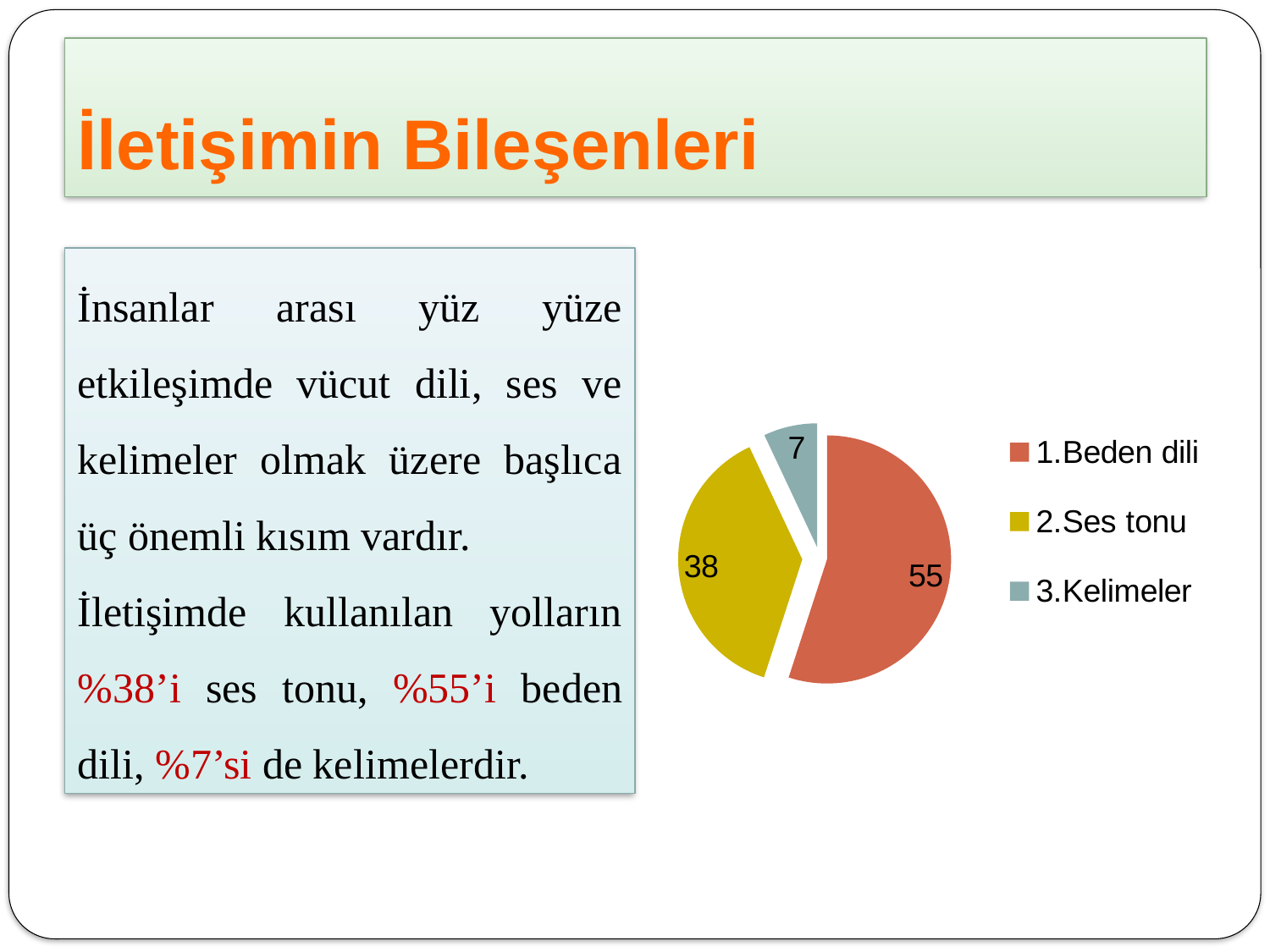
What is the value for 2.Ses tonu in the pie chart? 38 Which category has the smallest slice in the pie chart? 3.Kelimeler What is the value for 3.Kelimeler in the pie chart? 7 Which category has the largest slice in the pie chart? 1.Beden dili What share of the pie does 1.Beden dili represent? 55% What is the value for 1.Beden dili in the pie chart? 55 What is the difference between the values for 1.Beden dili and 2.Ses tonu? 17 How many slices does the pie chart have? 3 Which is larger, the value for 2.Ses tonu or the value for 3.Kelimeler? 2.Ses tonu What is the difference between the values for 2.Ses tonu and 3.Kelimeler? 31 What colour is the slice for 2.Ses tonu in the pie chart? yellow What kind of chart is shown on the slide? pie chart